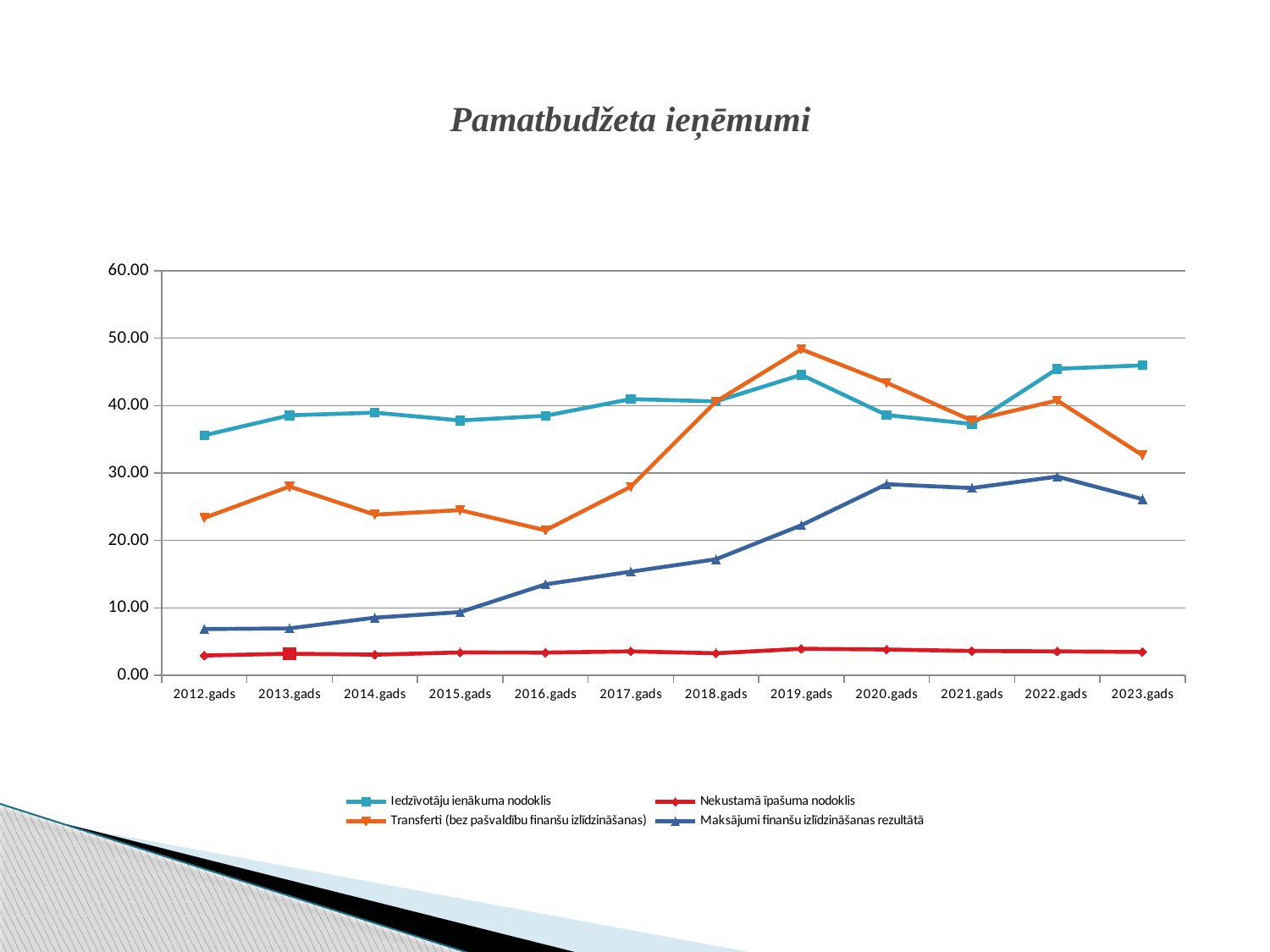
Does the Maksājumi finanšu izlīdzināšanas rezultātā line rise or fall from 2012.gads to 2022.gads? rise How many years are shown on the x axis? 12 Is the value for Iedzīvotāju ienākuma nodoklis in 2023.gads greater or less than 40.00? greater Is the value for Maksājumi finanšu izlīdzināšanas rezultātā in 2012.gads greater or less than 10.00? less In which year is Transferti (bez pašvaldību finanšu izlīdzināšanas) at its lowest value? 2016.gads What kind of chart is shown on the slide? line chart In 2019.gads, which is larger: Transferti (bez pašvaldību finanšu izlīdzināšanas) or Iedzīvotāju ienākuma nodoklis? Transferti (bez pašvaldību finanšu izlīdzināšanas) Is the value for Transferti (bez pašvaldību finanšu izlīdzināšanas) in 2019.gads greater or less than 40.00? greater In which year does Transferti (bez pašvaldību finanšu izlīdzināšanas) reach its highest value? 2019.gads What is the title of the chart? Pamatbudžeta ieņēmumi In 2023.gads, which is larger: Iedzīvotāju ienākuma nodoklis or Transferti (bez pašvaldību finanšu izlīdzināšanas)? Iedzīvotāju ienākuma nodoklis How many series does the legend list? 4